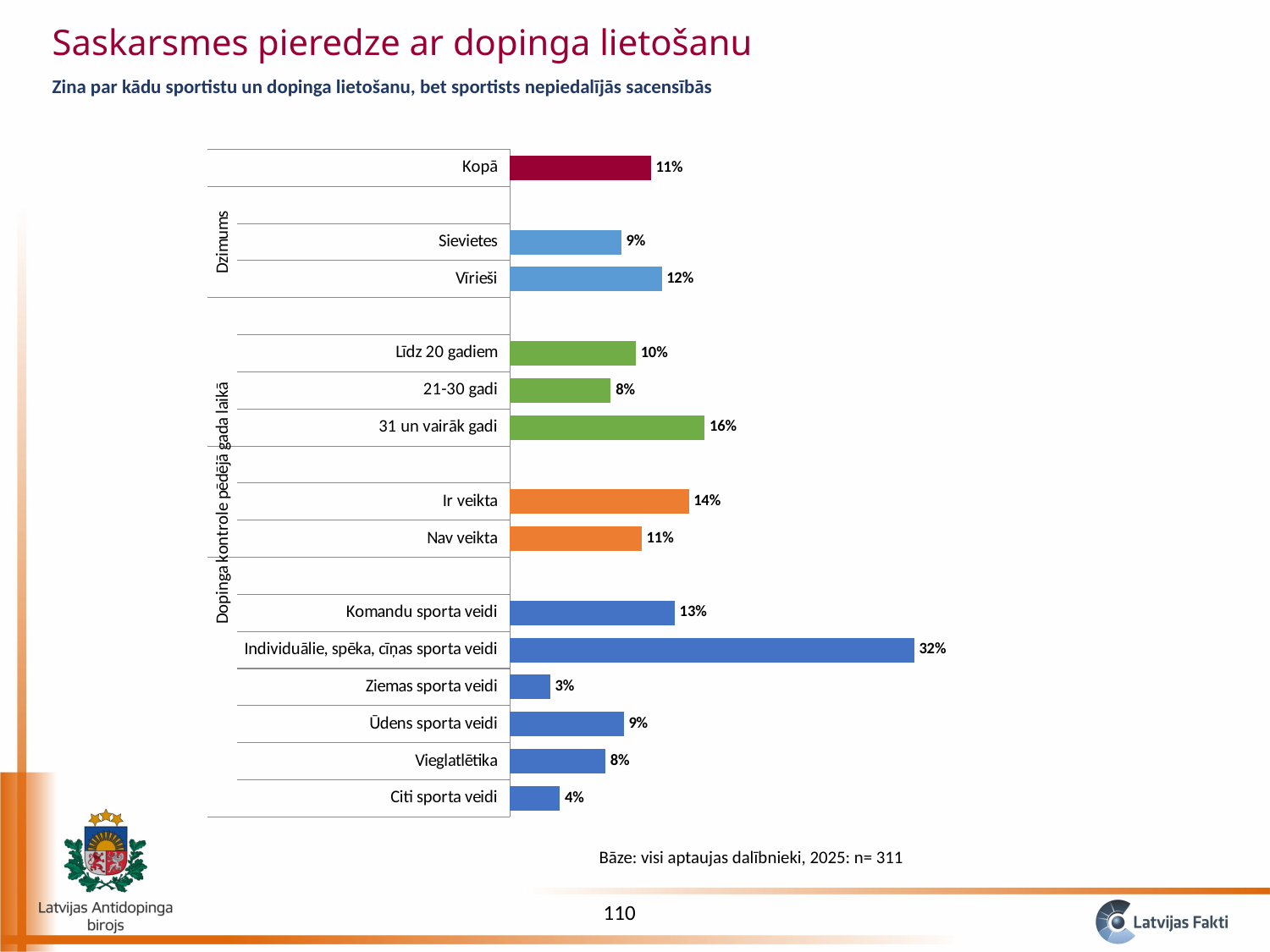
What is the value for Ziemas sporta veidi? 3% Which category has the highest value? Individuālie, spēka, cīņas sporta veidi What is the difference between the values for Vīrieši and Sievietes? 3% How many bars are plotted in the chart? 14 What is the base (n) stated below the chart? n= 311 What is the value for 31 un vairāk gadi? 16% Which is larger, the value for Komandu sporta veidi or the value for Ūdens sporta veidi? Komandu sporta veidi What is the difference between the values for Ir veikta and Nav veikta? 3% What is the value for Kopā? 11% What is the value for Individuālie, spēka, cīņas sporta veidi? 32% Which category has the lowest value? Ziemas sporta veidi What kind of chart is shown on the slide? Bar chart